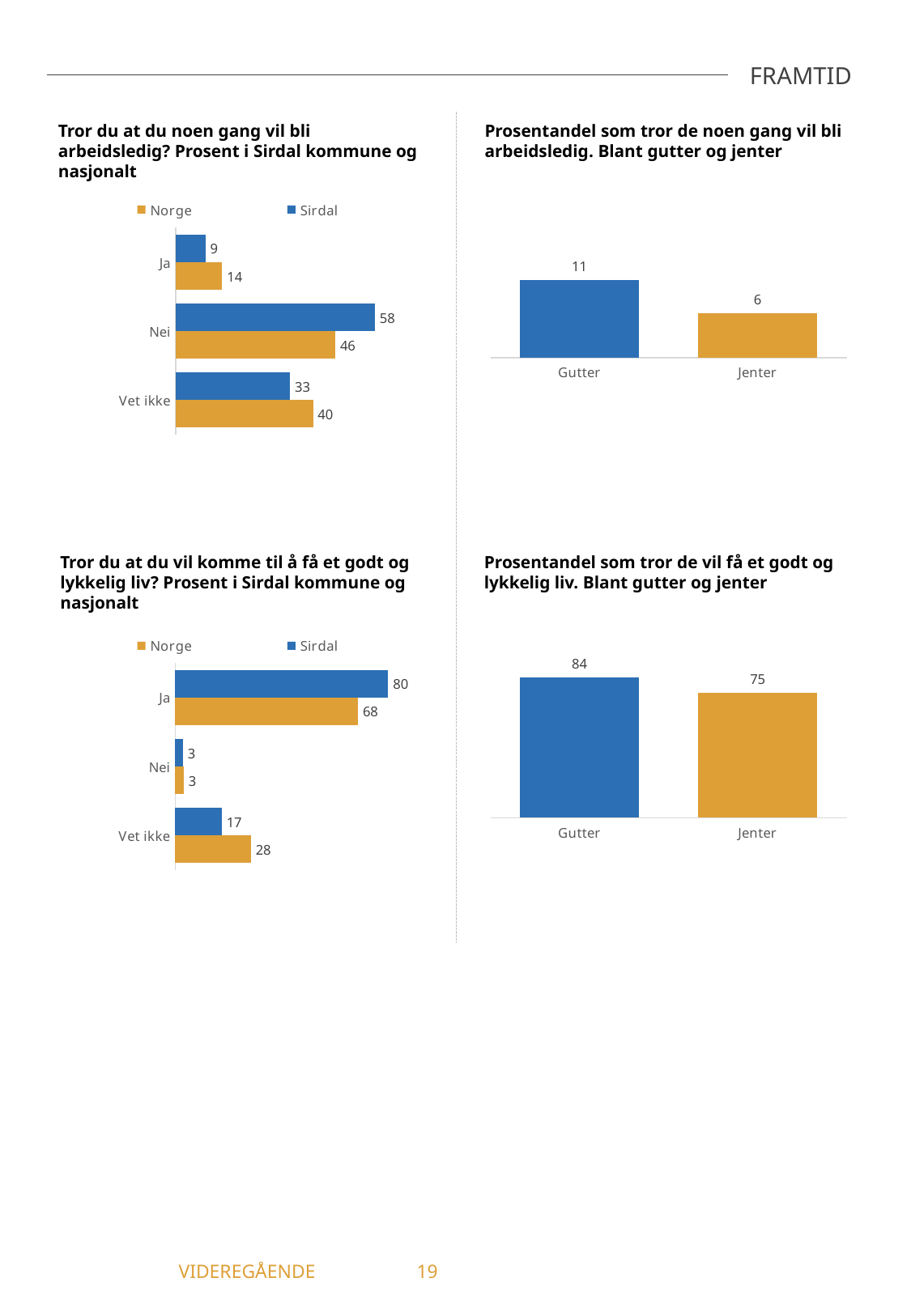
In the bottom-right chart (Prosentandel som tror de vil få et godt og lykkelig liv), what is the difference between Gutter and Jenter? 9 In the top-left chart (Tror du at du noen gang vil bli arbeidsledig?), how many series does the legend list? 2 In the bottom-left chart (Tror du at du vil komme til å få et godt og lykkelig liv?), how many categories are shown on the axis? 3 In the bottom-left chart (Tror du at du vil komme til å få et godt og lykkelig liv?), which is larger for Vet ikke: Norge or Sirdal? Norge What kind of chart is the top-right chart (Prosentandel som tror de noen gang vil bli arbeidsledig)? Bar chart In the bottom-right chart (Prosentandel som tror de vil få et godt og lykkelig liv), which category has the highest value? Gutter In the top-left chart (Tror du at du noen gang vil bli arbeidsledig?), what is the value for Norge in the Vet ikke category? 40 In the bottom-left chart (Tror du at du vil komme til å få et godt og lykkelig liv?), what is the value for Sirdal in the Ja category? 80 In the top-left chart (Tror du at du noen gang vil bli arbeidsledig?), what is the difference between the Sirdal and Norge values for Nei? 12 In the top-left chart (Tror du at du noen gang vil bli arbeidsledig?), what is the value for Sirdal in the Nei category? 58 In the top-right chart (Prosentandel som tror de noen gang vil bli arbeidsledig), which category has the lowest value? Jenter In the top-right chart (Prosentandel som tror de noen gang vil bli arbeidsledig), what is the value for Gutter? 11